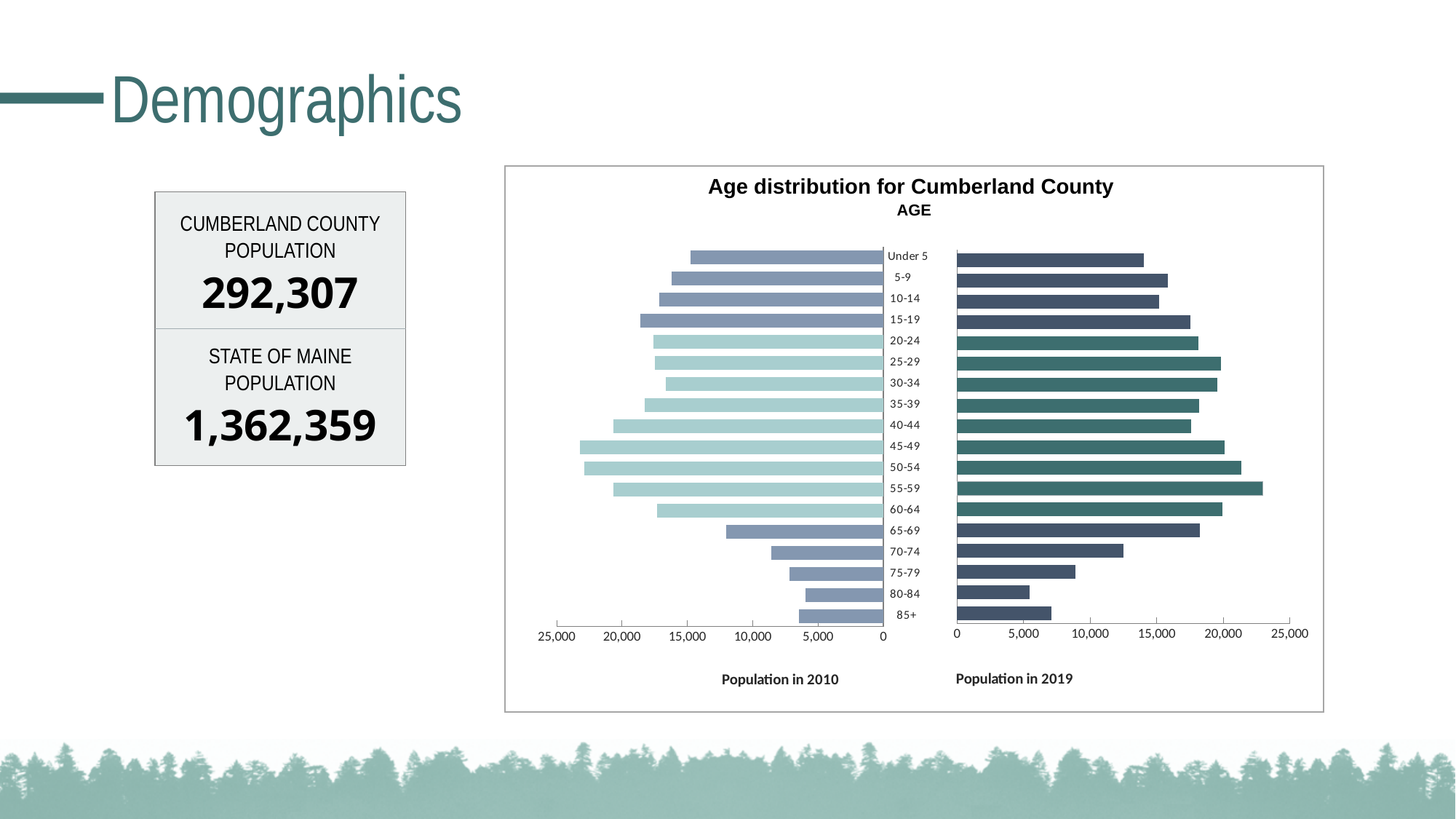
What kind of chart is used to show the age distribution for Cumberland County? Bar chart What is the title of the chart on the slide? Age distribution for Cumberland County In the Population in 2010 side of the chart, which age group has the largest population? 45-49 Is the 2010 population for the 45-49 age group greater or less than 20,000? greater How many population series (years) does the age distribution chart show? 2 For the 45-49 age group, which is larger: the population in 2010 or the population in 2019? Population in 2010 Is the 2019 population for the 70-74 age group greater or less than 10,000? greater In the Population in 2019 side of the chart, which age group has the largest population? 55-59 For the 70-74 age group, which is larger: the population in 2010 or the population in 2019? Population in 2019 How many age groups are shown in the age distribution chart? 18 Is the 2019 population for the 80-84 age group greater or less than 10,000? less In the Population in 2019 side of the chart, which age group has the smallest population? 80-84